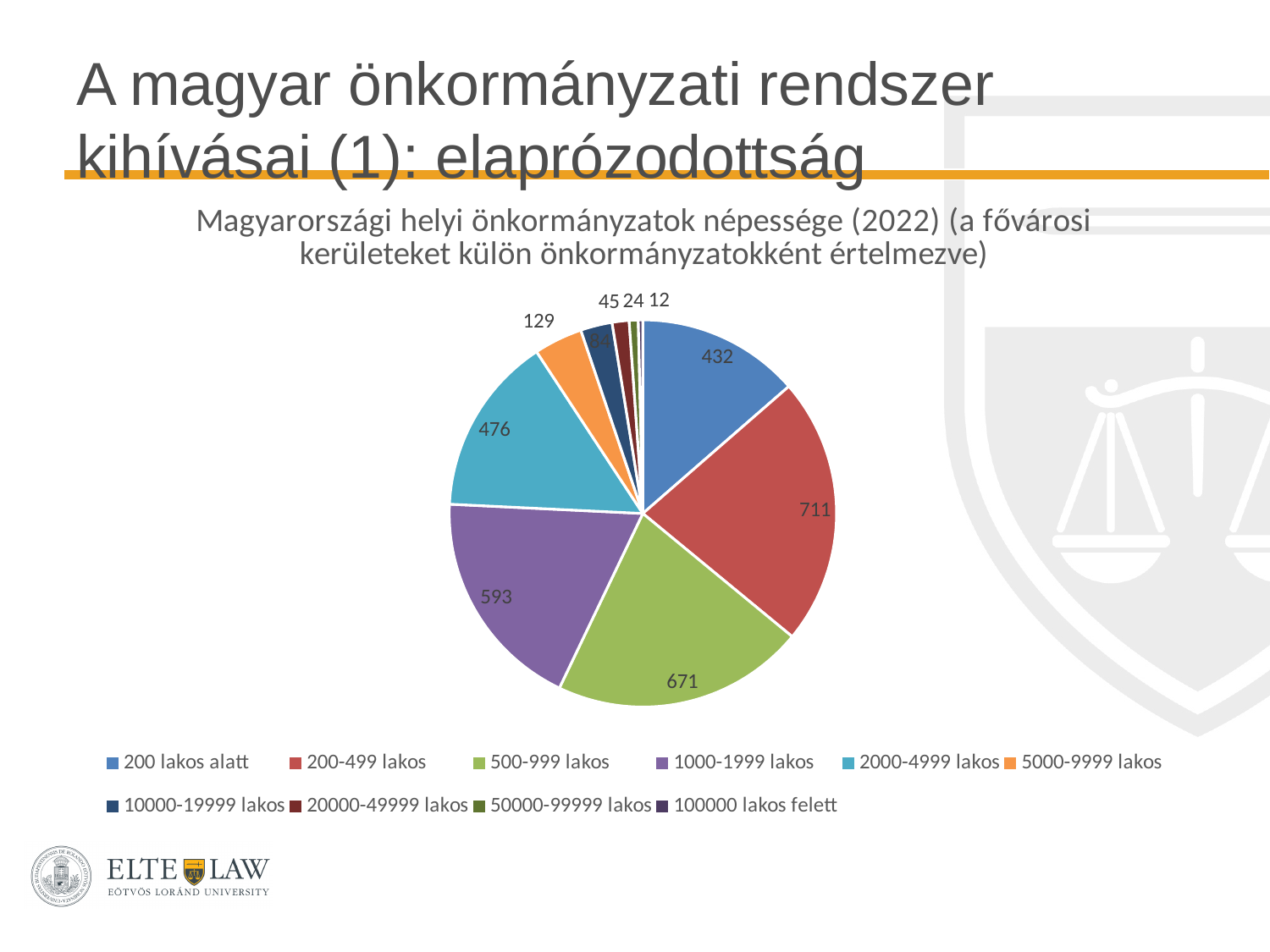
Which is larger, the value for 500-999 lakos or for 1000-1999 lakos? 500-999 lakos How many local governments are in the 200-499 lakos category? 711 Which category has the largest slice of the pie? 200-499 lakos What kind of chart is shown on the slide? pie chart What is the difference between the values for 200-499 lakos and 500-999 lakos? 40 What year does the chart title say the population data refers to? 2022 What is the difference between the values for 1000-1999 lakos and 2000-4999 lakos? 117 What is the value for the 2000-4999 lakos category? 476 Which category has the smallest slice of the pie? 100000 lakos felett How many categories does the legend of the pie chart list? 10 What is the value for the 200 lakos alatt category? 432 What is the value for the 5000-9999 lakos category? 129